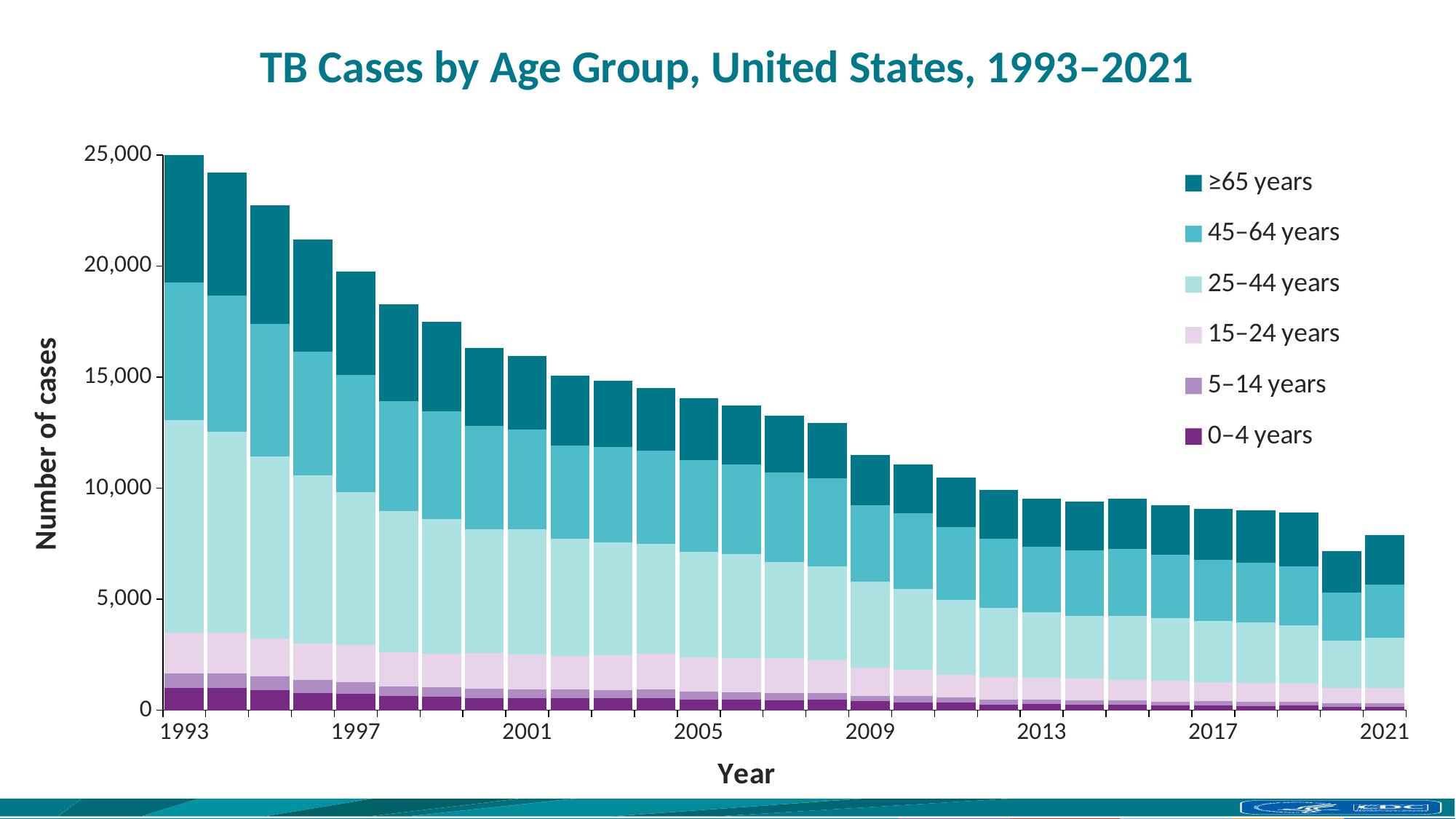
How many series does the legend list? 6 Which year has a larger total number of TB cases, 2009 or 2013? 2009 What is the title of the chart? TB Cases by Age Group, United States, 1993–2021 Is the total number of TB cases in 2009 greater or less than 10,000? greater What kind of chart is shown on the slide? Stacked bar chart Which year has the lowest total number of TB cases? 2020 Do the total TB cases generally rise or fall from 1993 to 2021? Fall Which year has the highest total number of TB cases? 1993 Is the total number of TB cases in 2021 greater or less than 10,000? less How many years (bars) are plotted on the chart? 29 What is the label on the y axis? Number of cases Is the total number of TB cases in 2005 greater or less than 15,000? less